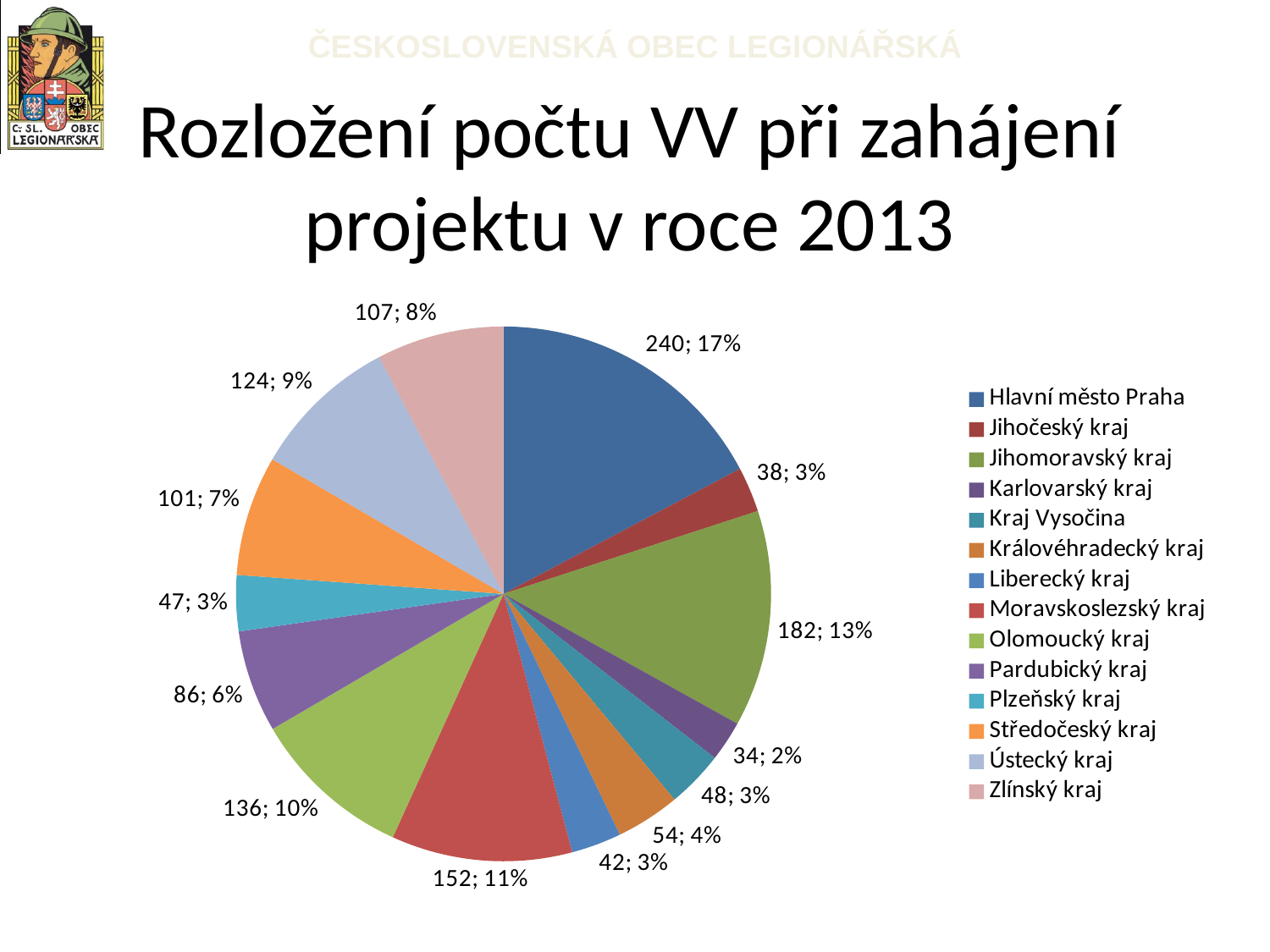
How many slices does the pie chart have? 14 Which region has the smallest slice of the pie? Karlovarský kraj What is the value shown for Moravskoslezský kraj? 152 What is the value shown for Hlavní město Praha? 240 Which region has the largest slice of the pie? Hlavní město Praha Which is larger, the value for Středočeský kraj or the value for Zlínský kraj? Zlínský kraj What is the value shown for Ústecký kraj? 124 What type of chart is shown on the slide? pie chart What share of the pie does Jihomoravský kraj represent? 13% What is the difference between the values for Hlavní město Praha and Jihomoravský kraj? 58 What share of the pie does Olomoucký kraj represent? 10% What is the title of the chart on the slide? Rozložení počtu VV při zahájení projektu v roce 2013